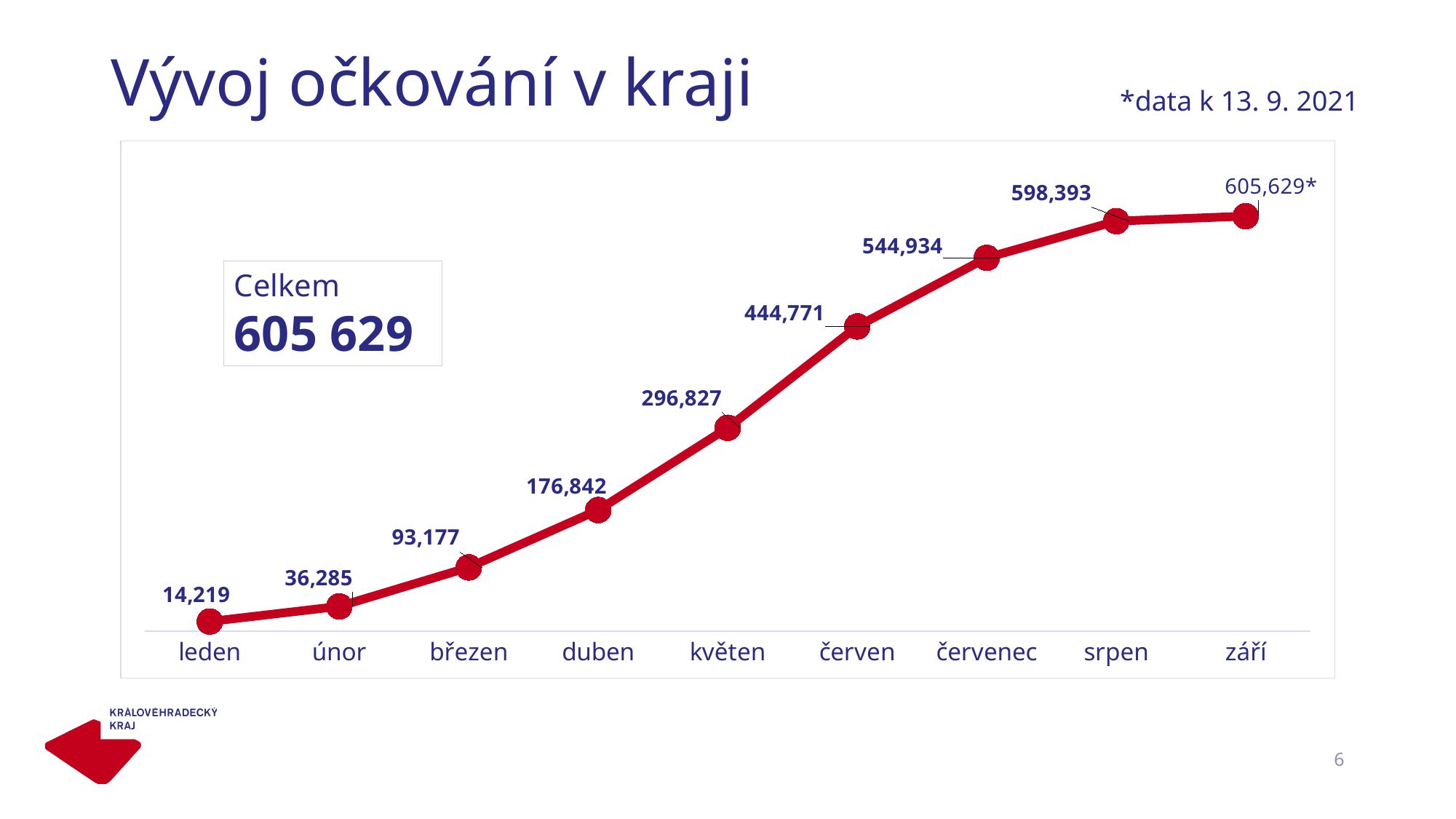
What is the difference between the values for září and srpen? 7,236 Which is larger, the value for červen or the value for květen? červen What is the value for červenec? 544,934 Which month has the highest value? září What is the value for leden? 14,219 What is the value for září? 605,629 What kind of chart is shown on the slide? line chart What is the value for květen? 296,827 Do the values rise or fall from leden to září? rise How many months are plotted on the chart? 9 Which month has the lowest value? leden What is the difference between the values for duben and březen? 83,665